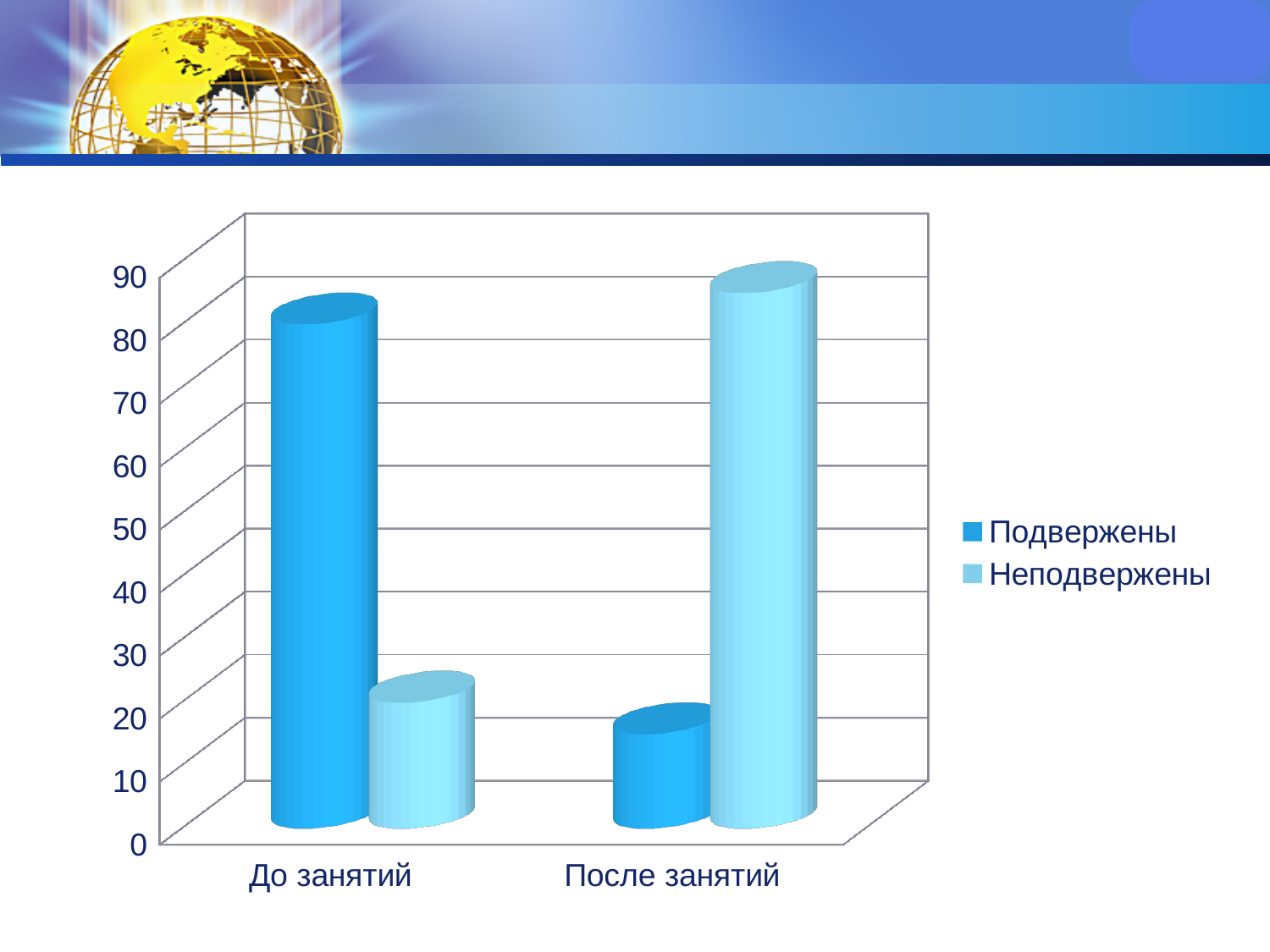
Is the value for Подвержены in До занятий greater or less than 50? greater Does the value for Подвержены rise or fall from До занятий to После занятий? fall How many categories are shown on the x axis? 2 In the До занятий category, which series has the larger value, Подвержены or Неподвержены? Подвержены Which series is shown in the darker blue colour? Подвержены Is the value for Подвержены in После занятий greater or less than 30? less What kind of chart is shown on the slide? bar chart Is the value for Неподвержены in До занятий greater or less than 40? less What are the two categories on the x axis? До занятий, После занятий In the После занятий category, which series has the larger value, Подвержены or Неподвержены? Неподвержены How many series does the legend list? 2